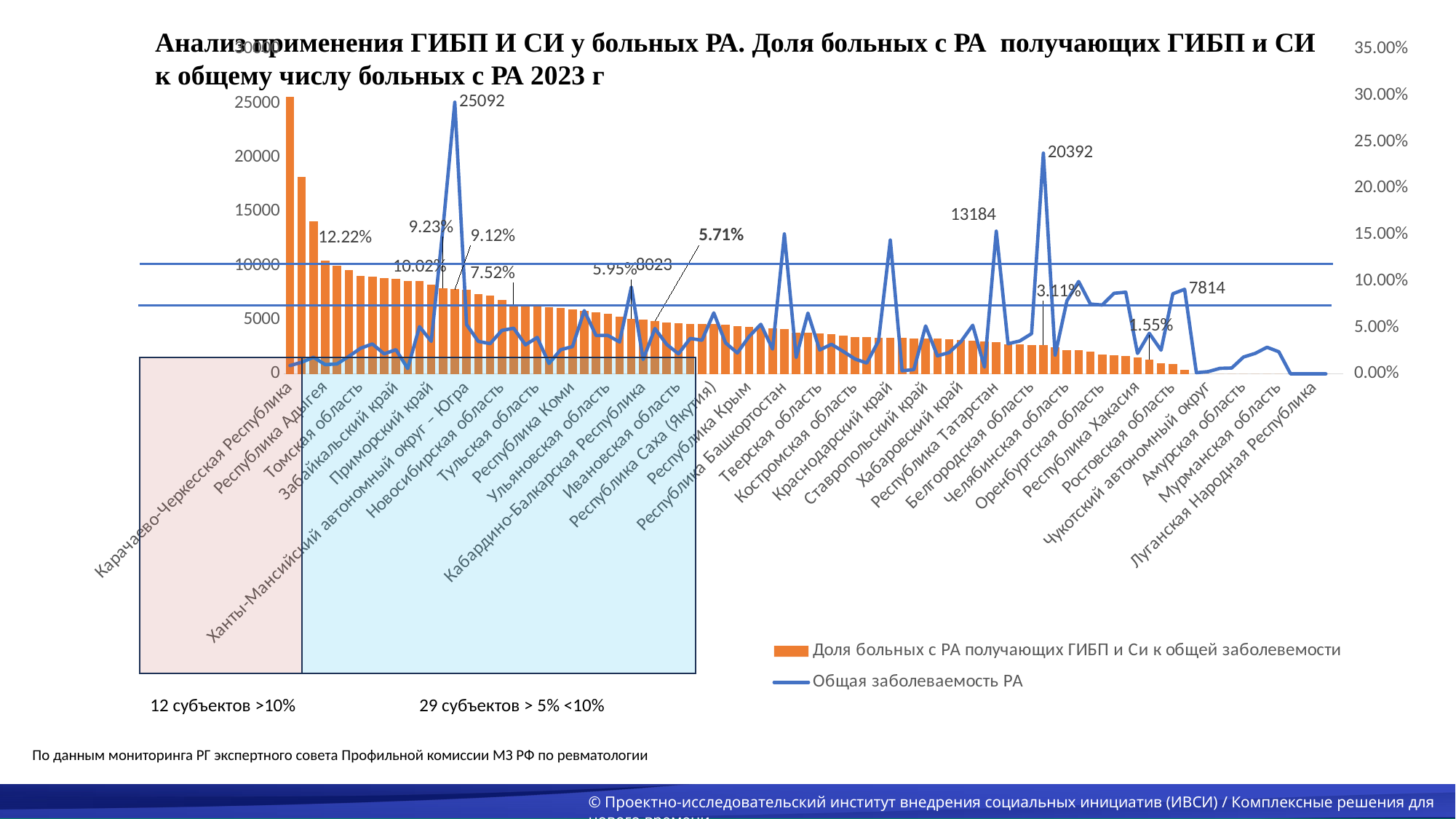
What year does the chart title refer to? 2023 According to the annotation under the chart, how many subjects have a share greater than 10%? 12 What is the highest value labeled on the line series? 25092 How many series does the legend list? 2 What is the difference between the two highest labeled line values, 25092 and 20392? 4700 According to the annotation under the chart, how many subjects have a share between 5% and 10%? 29 Do the bar values rise or fall from left to right along the x axis? Fall What kind of chart is shown on the slide? A combination bar and line chart Which has the larger bar: Карачаево-Черкесская Республика or Луганская Народная Республика? Карачаево-Черкесская Республика Which category has the highest bar? Карачаево-Черкесская Республика Which series is drawn as a blue line according to the legend? Общая заболеваемость РА